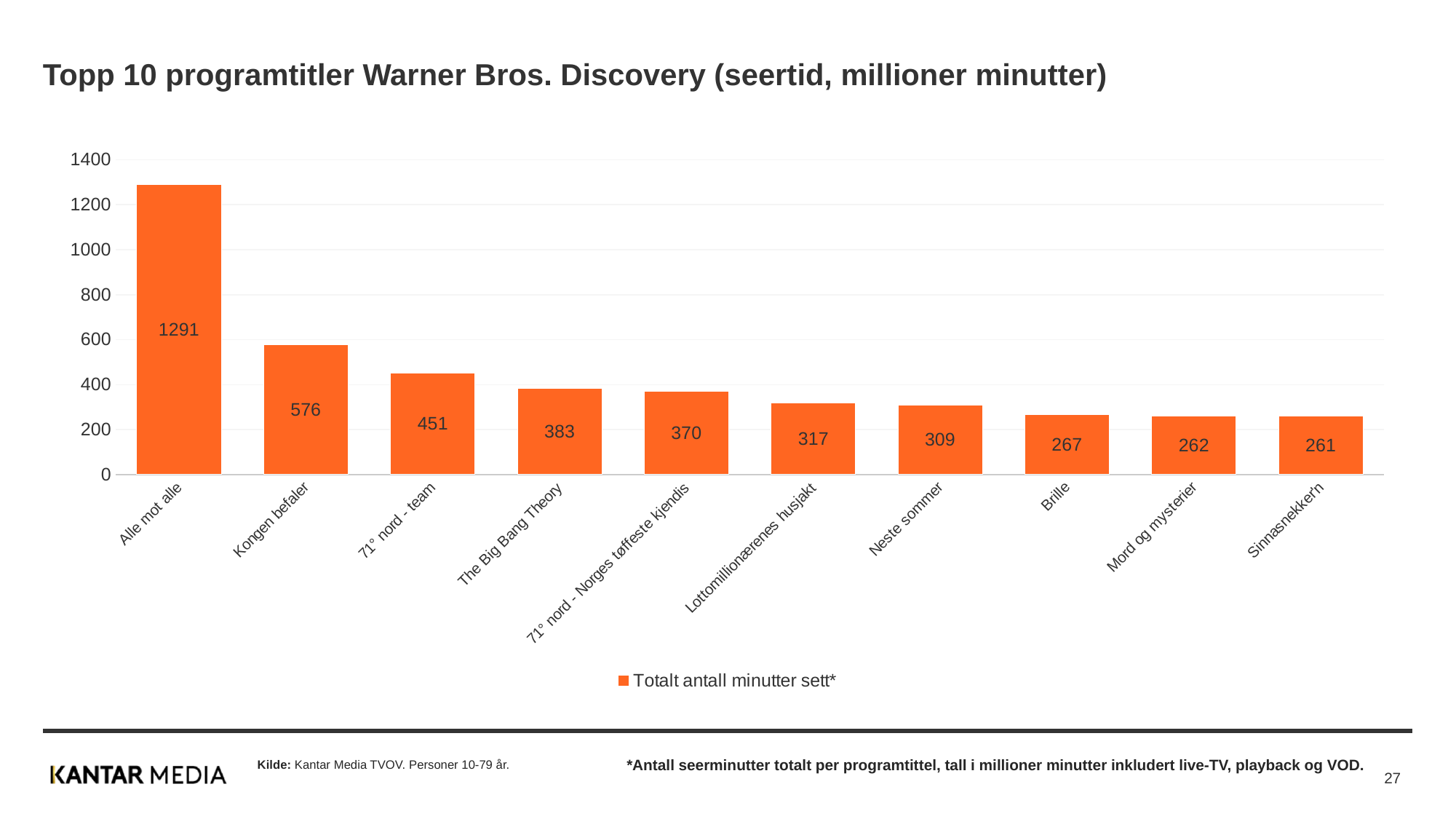
What kind of chart is shown on the slide? Bar chart Which program title has the lowest value? Sinnasnekker'n How many series does the legend list? 1 Which program title has the highest value? Alle mot alle What is the legend entry for the series in the chart? Totalt antall minutter sett* What is the value for The Big Bang Theory? 383 What is the value for Alle mot alle? 1291 What is the difference between the values for Alle mot alle and Kongen befaler? 715 Which is larger, the value for 71° nord - team or the value for Brille? 71° nord - team What is the value for Neste sommer? 309 What is the value for Kongen befaler? 576 How many program titles are shown in the chart? 10